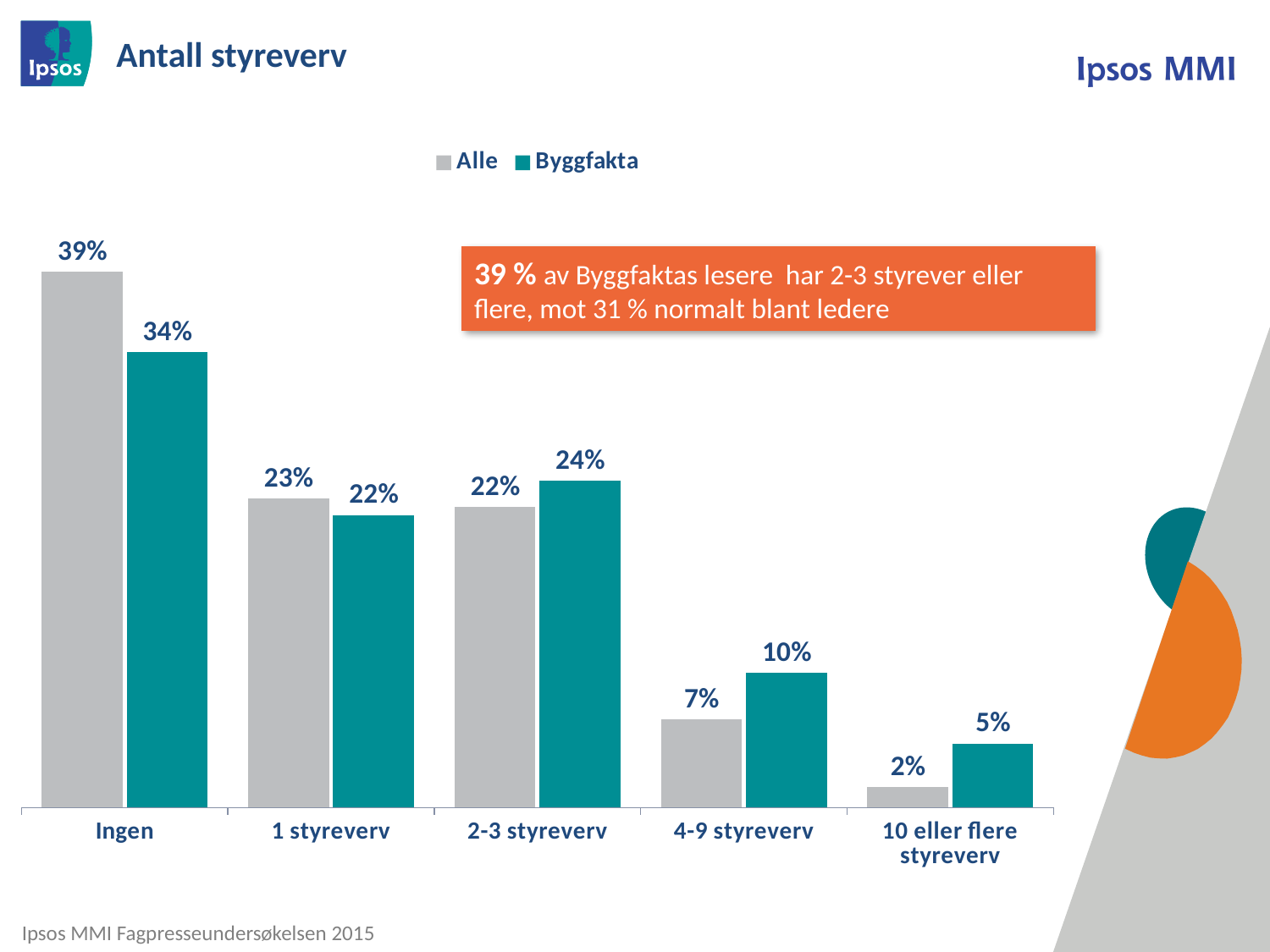
What is the value for Byggfakta in the Ingen category? 34% What kind of chart is shown on the slide? Bar chart What is the value for Byggfakta in the 10 eller flere styreverv category? 5% What is the value for Alle in the 2-3 styreverv category? 22% In the 2-3 styreverv category, which series has the larger value, Alle or Byggfakta? Byggfakta How many categories are shown on the x axis? 5 How many series does the legend list? 2 Which category has the lowest value for Byggfakta? 10 eller flere styreverv Which category has the highest value for Alle? Ingen What is the difference between Byggfakta and Alle in the 4-9 styreverv category? 3% What is the title of the chart? Antall styreverv What is the difference between Alle and Byggfakta in the Ingen category? 5%